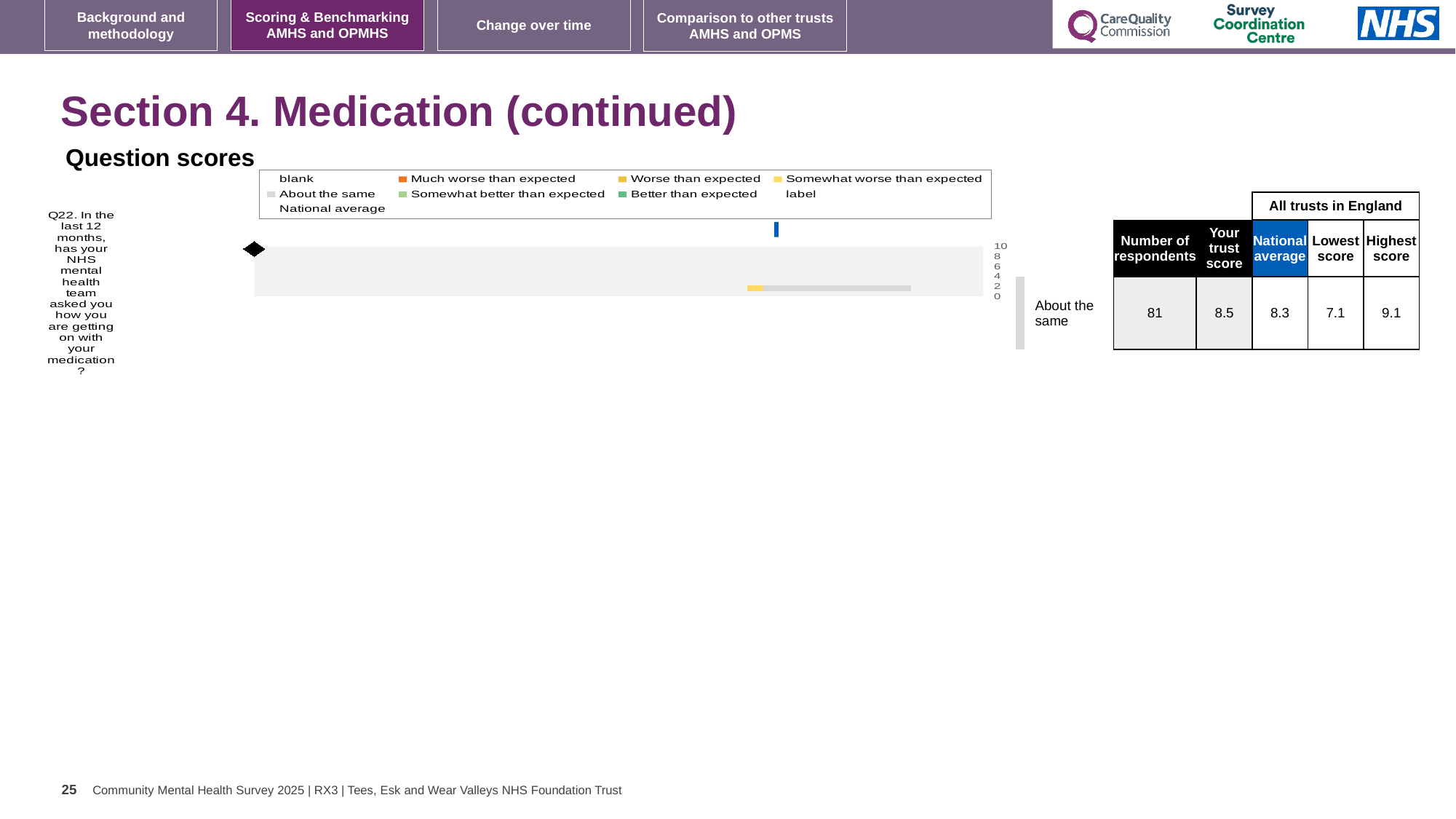
For Q22, what is the difference between the highest score and the lowest score across all trusts in England? 2.0 What is the national average for Q22 shown in the table beside the chart? 8.3 Which question number is plotted in the Question scores chart? Q22 What is the lowest score across all trusts in England for Q22? 7.1 What is the trust score for Q22 shown in the table beside the chart? 8.5 How many respondents answered Q22? 81 For Q22, which is larger: the trust score or the national average? the trust score What is the highest tick value shown on the score axis of the Question scores chart? 10 What comparison category is given for Q22 next to the chart? About the same What is the highest score across all trusts in England for Q22? 9.1 How many questions are plotted in the Question scores chart? 1 What kind of chart is shown under 'Question scores'? bar chart